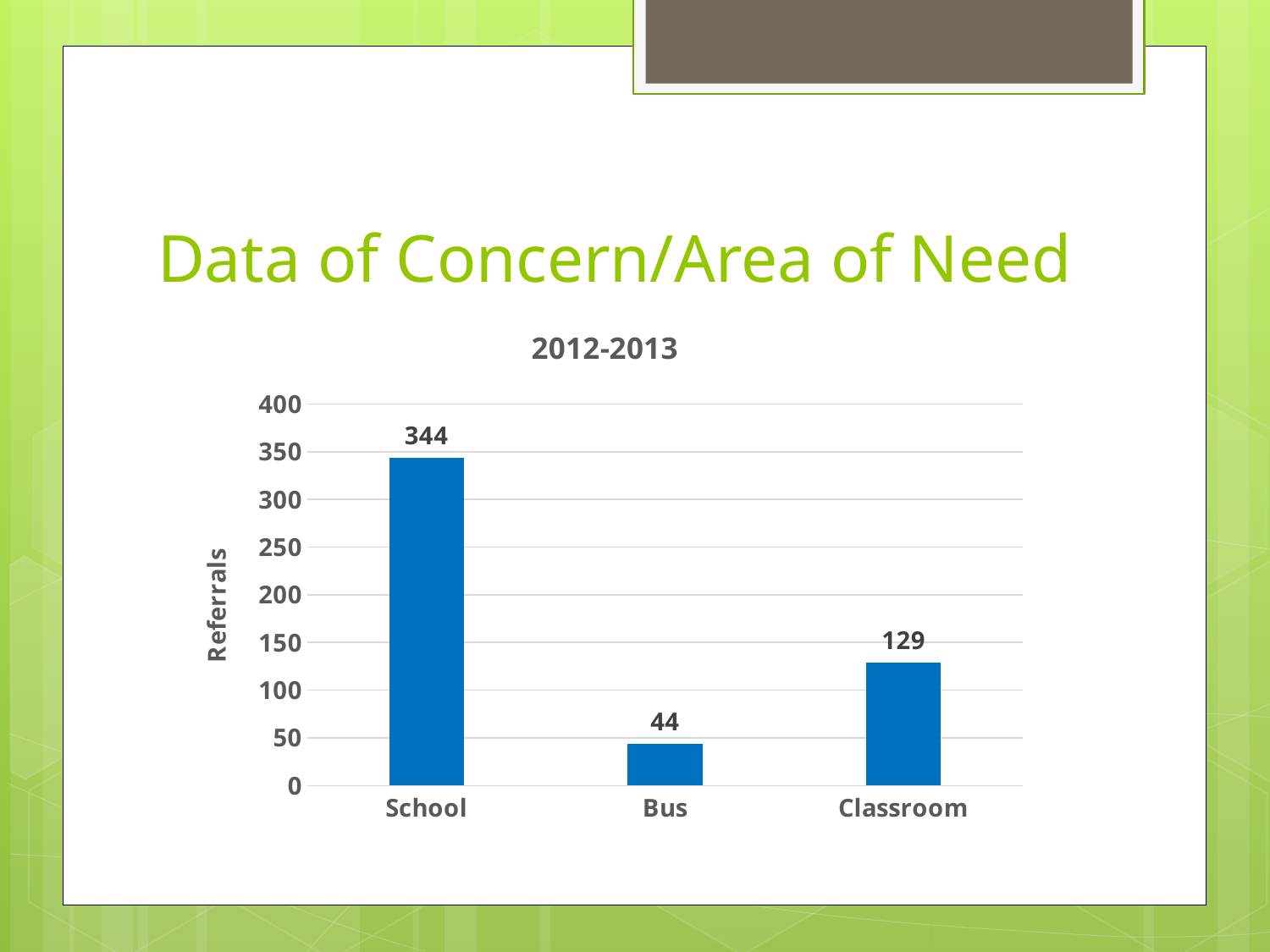
How many categories are shown on the x axis? 3 Which category has the highest number of referrals? School Which has more referrals, Bus or Classroom? Classroom What is the number of referrals for Classroom? 129 Which category has the lowest number of referrals? Bus What is the difference in referrals between Classroom and Bus? 85 What is the difference in referrals between School and Classroom? 215 What is the title of the chart? 2012-2013 What is the number of referrals for School? 344 Is the value for School greater or less than 300? greater What kind of chart is shown on the slide? Bar chart What is the number of referrals for Bus? 44